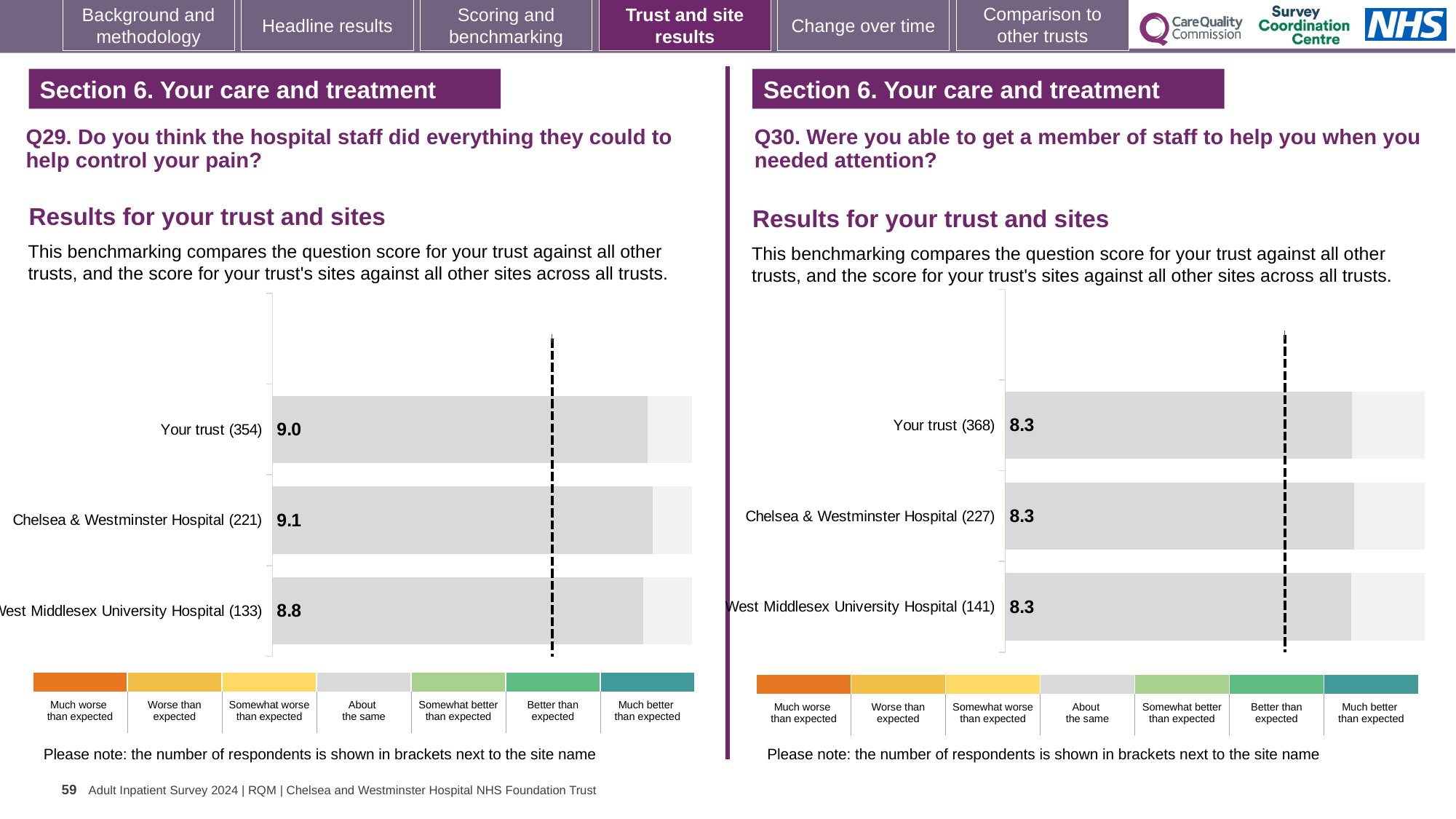
On the Q30 chart (right), what is the score for Your trust? 8.3 On the Q29 chart (left), which site or trust has the highest score? Chelsea & Westminster Hospital On the Q29 chart (left), which site or trust has the lowest score? West Middlesex University Hospital On the Q29 chart (left), what is the score for Your trust? 9.0 On the Q30 chart (right), what is the score for West Middlesex University Hospital? 8.3 On the Q29 chart (left), how many respondents are shown in brackets for Chelsea & Westminster Hospital? 221 On the Q29 chart (left), what is the score for Chelsea & Westminster Hospital? 9.1 On the Q29 chart (left), what is the difference between the scores for Chelsea & Westminster Hospital and West Middlesex University Hospital? 0.3 On the Q29 chart (left), what is the score for West Middlesex University Hospital? 8.8 What type of chart is used on the Q29 chart (left)? Bar chart On the Q30 chart (right), how many bars are plotted? 3 On the Q29 chart (left), which has the larger score: Your trust or West Middlesex University Hospital? Your trust